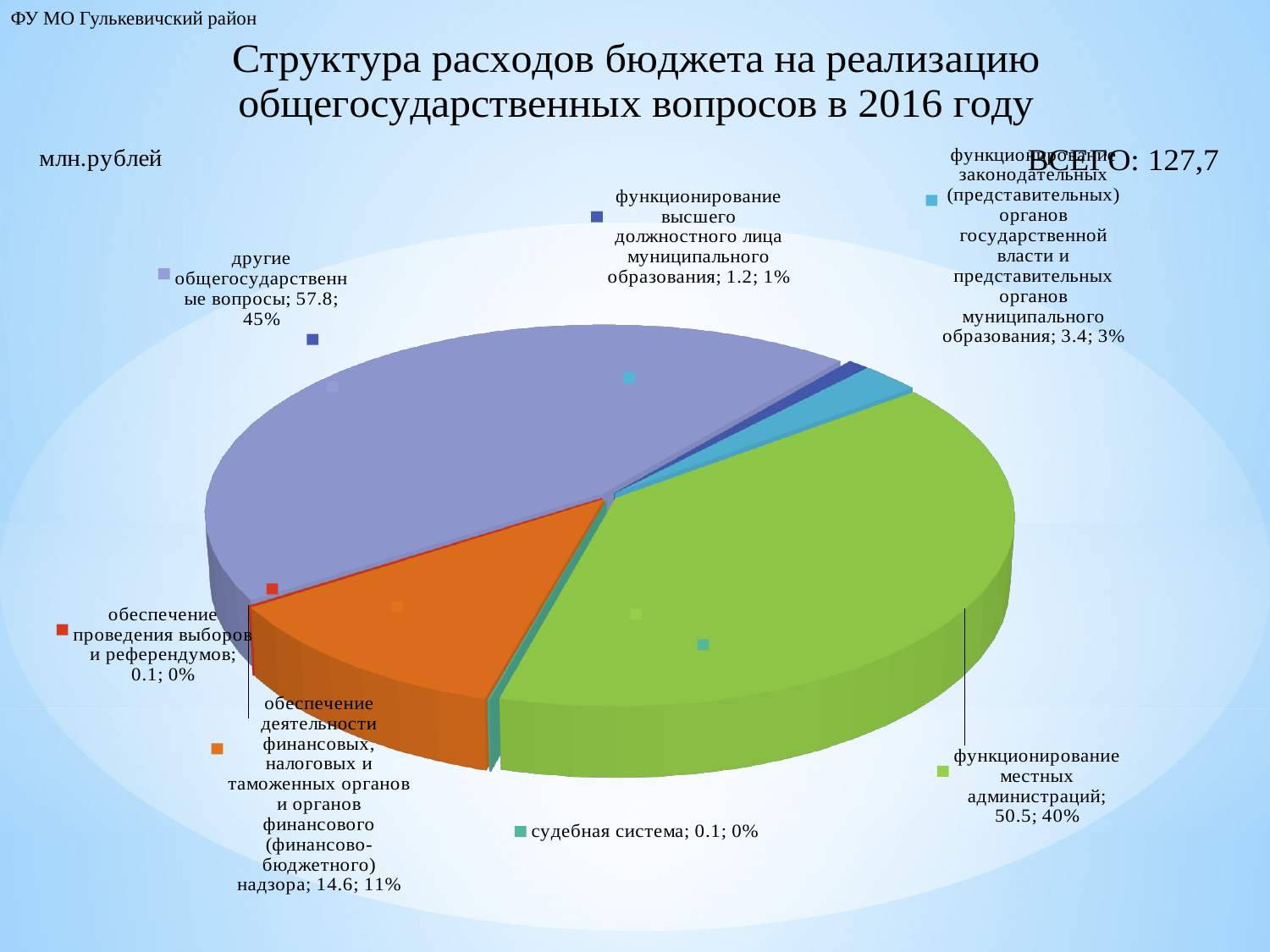
What is the difference between the values for другие общегосударственные вопросы and функционирование местных администраций? 7.3 What is the value for функционирование высшего должностного лица муниципального образования? 1.2 What is the value for обеспечение деятельности финансовых, налоговых и таможенных органов и органов финансового (финансово-бюджетного) надзора? 14.6 Which category has the largest slice of the pie? другие общегосударственные вопросы What is the value for функционирование местных администраций? 50.5 What is the value for другие общегосударственные вопросы? 57.8 What share of the pie does функционирование законодательных (представительных) органов государственной власти и представительных органов муниципального образования take? 3% How many categories (slices) does the pie chart have? 7 What share of the pie does функционирование местных администраций take? 40% What kind of chart is shown on the slide? pie chart Which is larger: the value for функционирование местных администраций or the value for обеспечение деятельности финансовых, налоговых и таможенных органов и органов финансового (финансово-бюджетного) надзора? функционирование местных администраций What total (ВСЕГО) is stated on the slide? 127,7